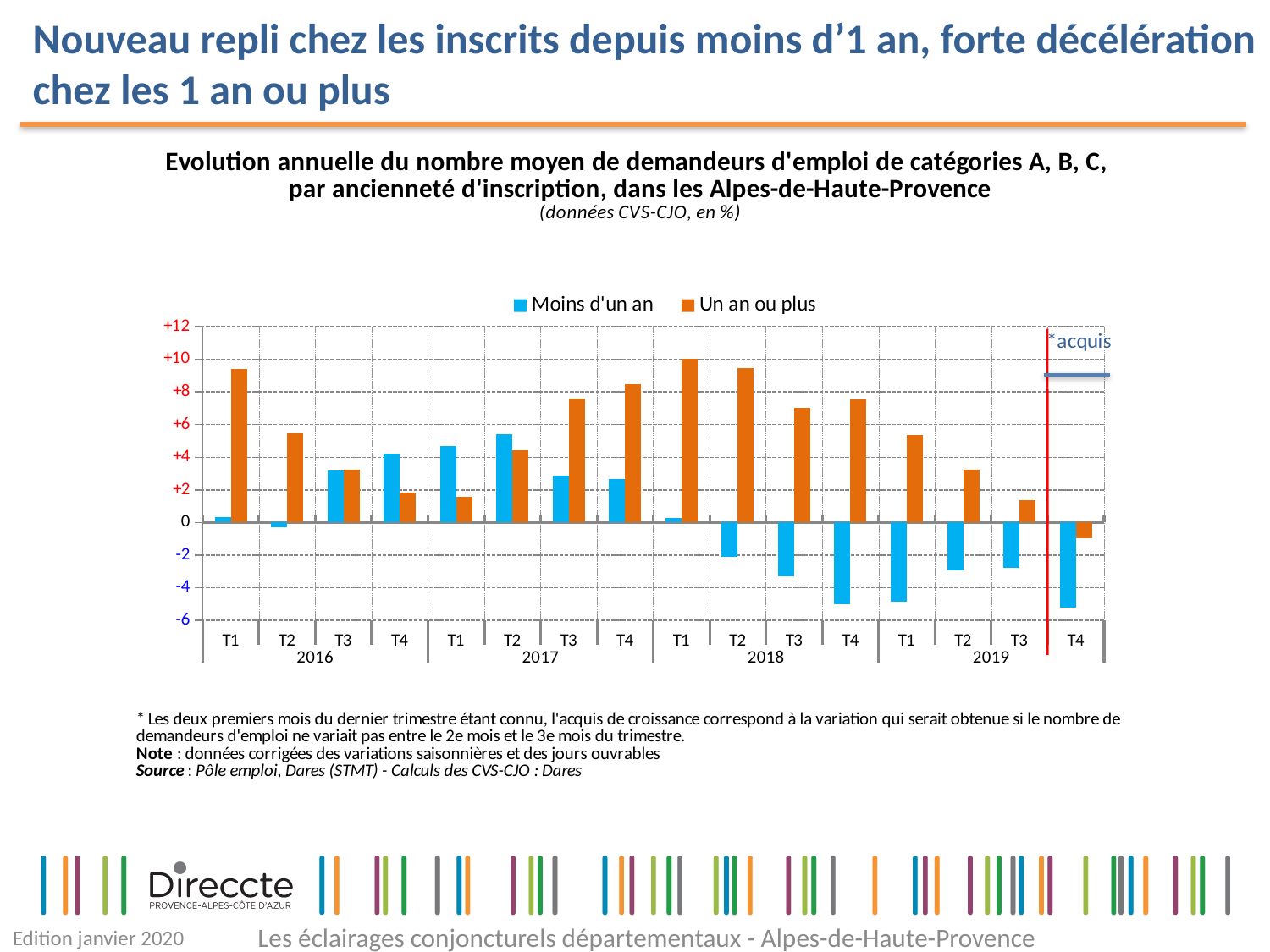
In which quarter does the 'Moins d'un an' series reach its highest value? T2 2017 How many series does the legend list? 2 What are the two series named in the legend? Moins d'un an; Un an ou plus What kind of chart is shown on the slide? bar chart Is the value for 'Moins d'un an' in T4 2018 greater or less than -4? less Is the value for 'Un an ou plus' in T3 2019 greater or less than +2? less In T1 2016, which series has the larger value, 'Moins d'un an' or 'Un an ou plus'? Un an ou plus Does the 'Moins d'un an' series rise or fall from T2 2017 to T4 2018? fall Is the value for 'Un an ou plus' in T1 2018 greater or less than +8? greater In T1 2017, which series has the larger value, 'Moins d'un an' or 'Un an ou plus'? Moins d'un an How many quarters (T1–T4 periods) are plotted along the x axis? 16